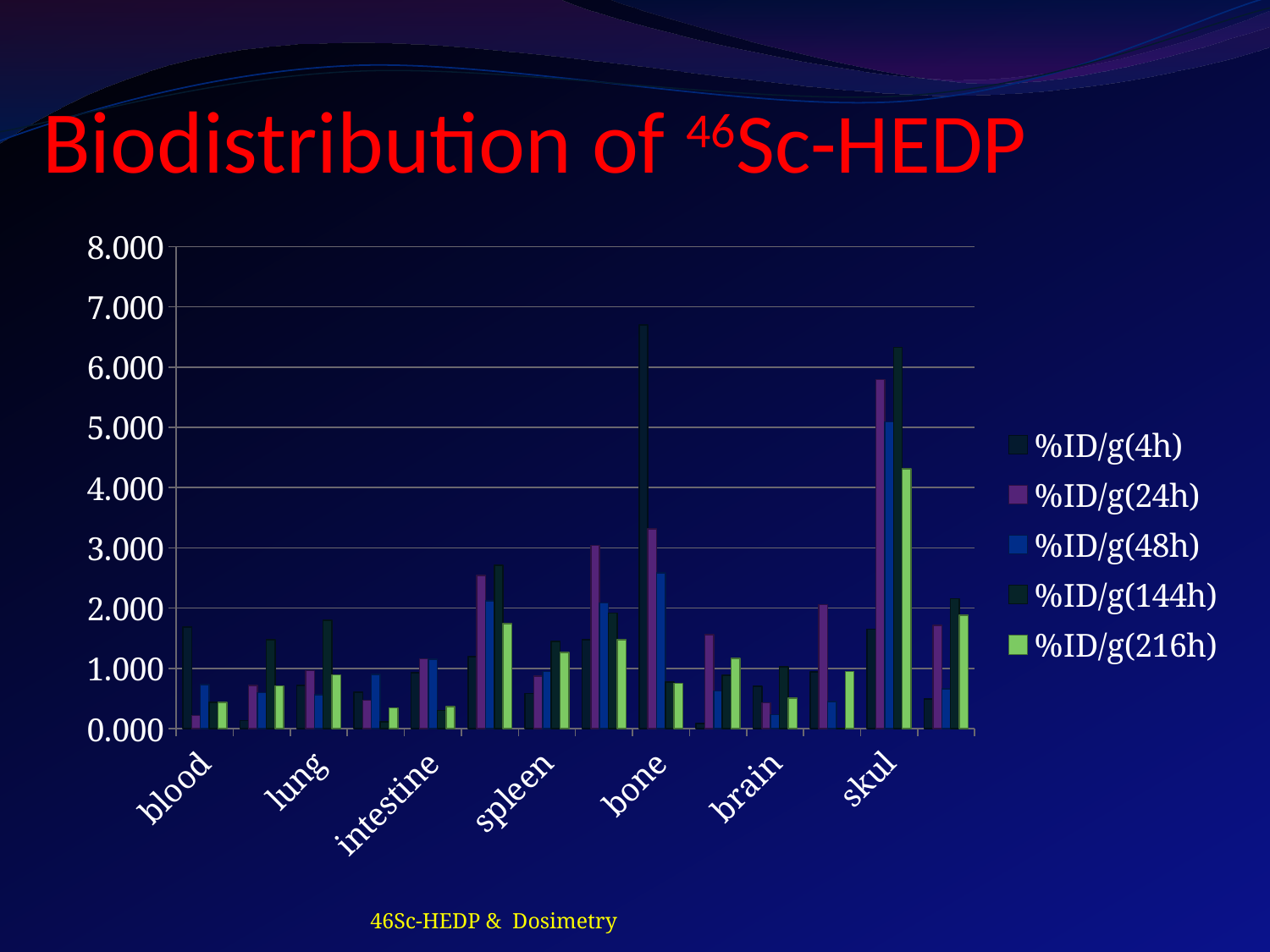
Which category has the highest %ID/g(216h) value? skul Which category has the highest %ID/g(144h) value? skul Is the %ID/g(24h) value for skul greater or less than 5.000? greater What is the title of the slide's chart? Biodistribution of 46Sc-HEDP Which category has the highest %ID/g(24h) value? skul How many series does the legend list? 5 For bone, which is larger: the %ID/g(144h) value or the %ID/g(24h) value? %ID/g(24h) Is the %ID/g(144h) value for bone greater or less than 6.000? less What is the highest value shown on the y axis? 8.000 For blood, which is larger: the %ID/g(4h) value or the %ID/g(24h) value? %ID/g(4h) What kind of chart is shown on the slide? bar chart Is the %ID/g(24h) value for blood greater or less than 1.000? less